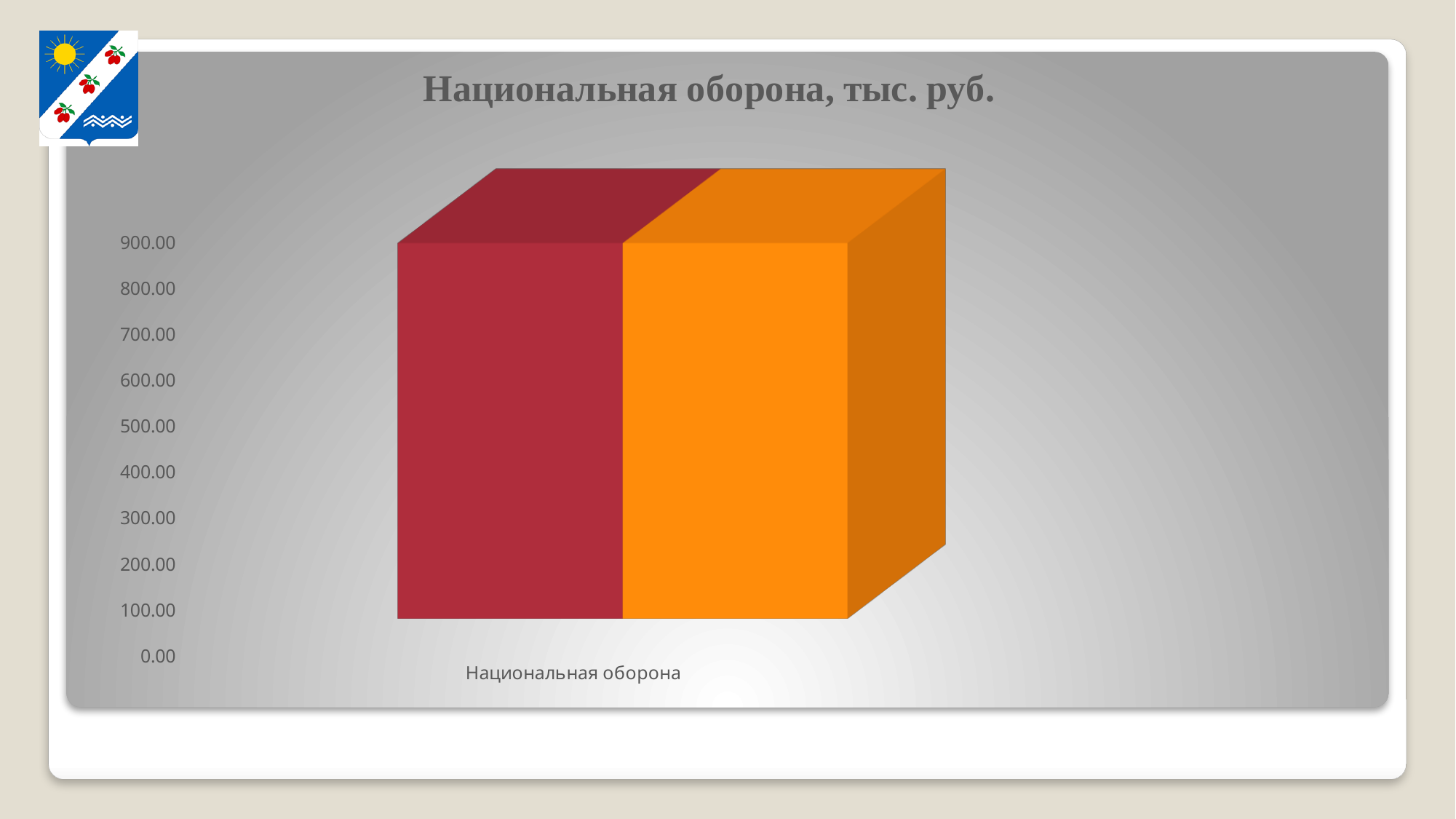
Is the value of the red bar for Национальная оборона greater or less than 500.00? greater How many bars are plotted for the category Национальная оборона? 2 Is the value of the red bar for Национальная оборона greater or less than 100.00? greater What kind of chart is shown on the slide? bar chart What is the title of the chart? Национальная оборона, тыс. руб. How many categories are shown on the x axis of the chart? 1 What is the category label shown on the x axis? Национальная оборона Is the value of the orange bar for Национальная оборона greater or less than 400.00? greater